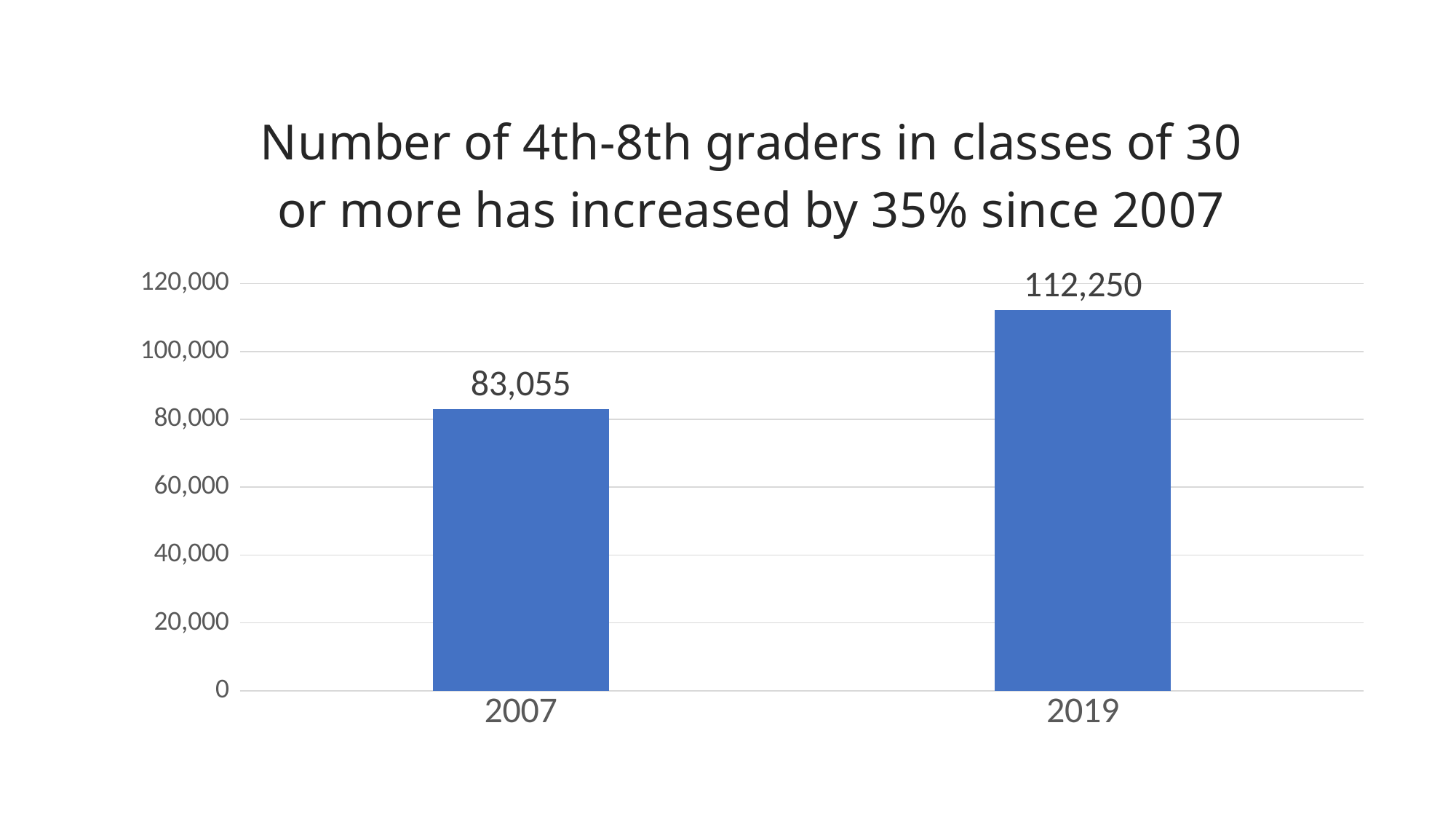
Is the value for 2019 greater or less than 100,000? greater What is the value for 2007? 83,055 How many bars are shown in the chart? 2 Is the value for 2019 larger than the value for 2007? Yes What is the difference between the 2019 value and the 2007 value? 29,195 Is the value for 2007 greater or less than 100,000? less Do the values rise or fall from 2007 to 2019? Rise What kind of chart is shown on the slide? Bar chart Which year has the higher value? 2019 Which year has the lower value? 2007 What is the value for 2019? 112,250 By what percentage does the chart title say the number has increased since 2007? 35%